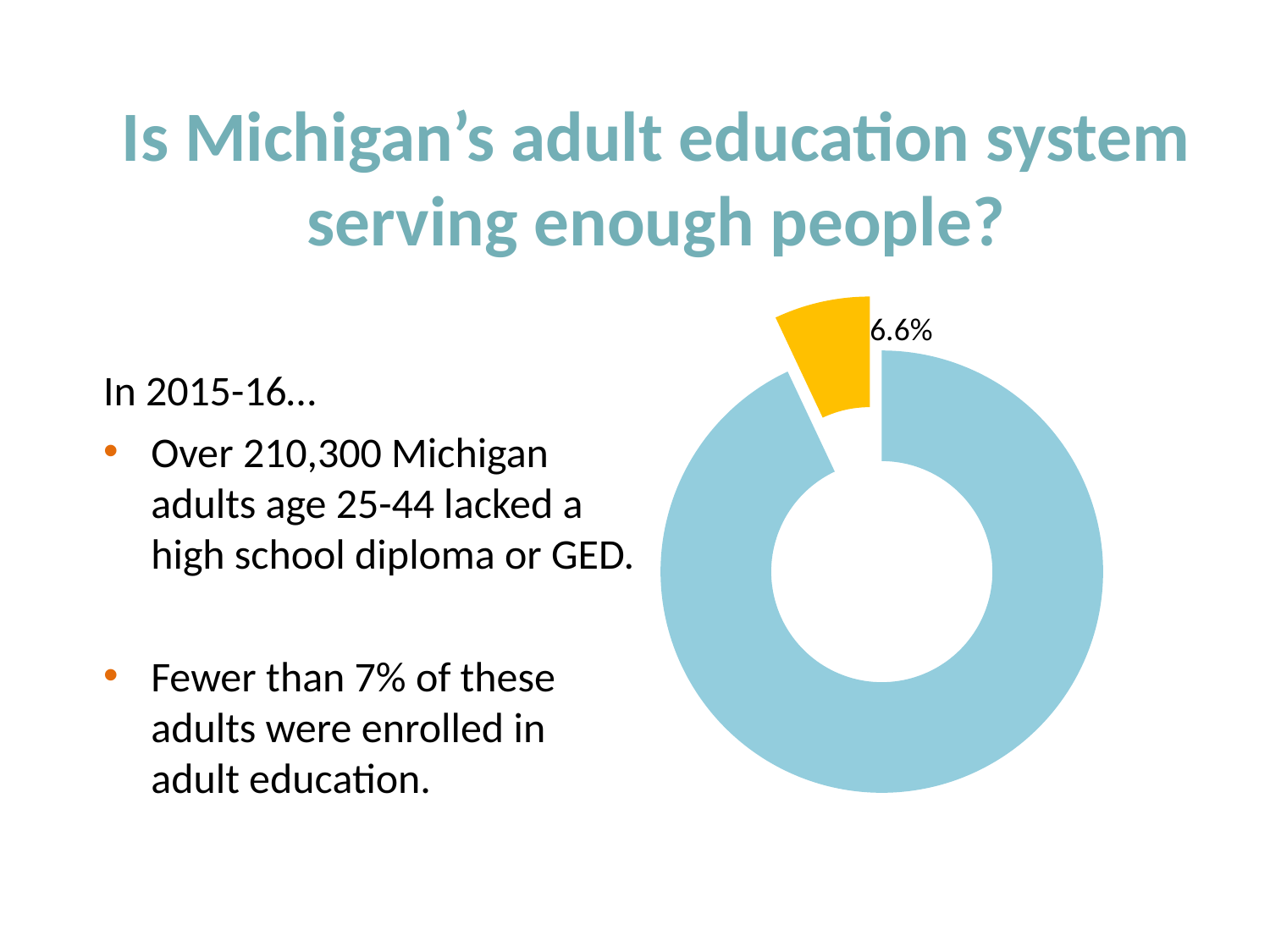
Does the doughnut chart have a legend? No Is the share of the yellow slice greater or less than 50%? less What colour is the slice that is pulled out from the rest of the doughnut chart? yellow Which slice of the doughnut chart is the smallest? the yellow slice What value is printed on the small yellow slice of the doughnut chart? 6.6% Which slice is larger, the blue slice or the yellow slice? the blue slice What share of the doughnut chart does the yellow slice represent? 6.6% What kind of chart is shown on the slide? doughnut chart Which slice of the doughnut chart is the largest? the blue slice How many slices does the doughnut chart have? 2